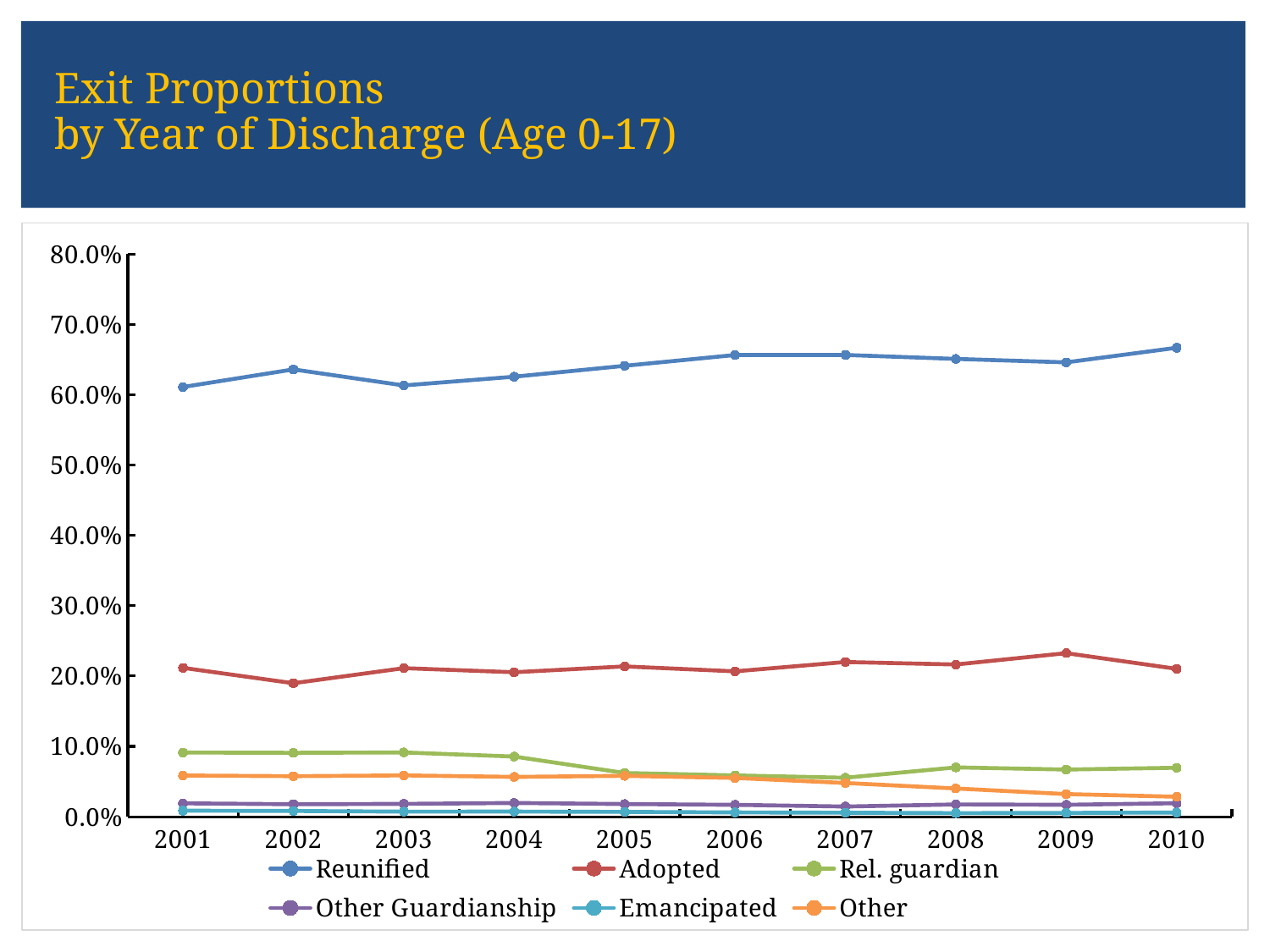
How many series does the legend list? 6 Does the Other series rise or fall from 2001 to 2010? fall How many years are plotted along the x axis? 10 Is the value for Adopted in 2002 greater or less than 20.0%? less Is the value for Reunified in 2001 greater or less than 60.0%? greater What kind of chart is shown on the slide? line chart Is the value for Other in 2010 greater or less than 10.0%? less What is the title of the chart slide? Exit Proportions by Year of Discharge (Age 0-17) In 2001, which is larger: Rel. guardian or Other? Rel. guardian Which series has the lowest values across the chart? Emancipated Which series has the highest value in 2010? Reunified